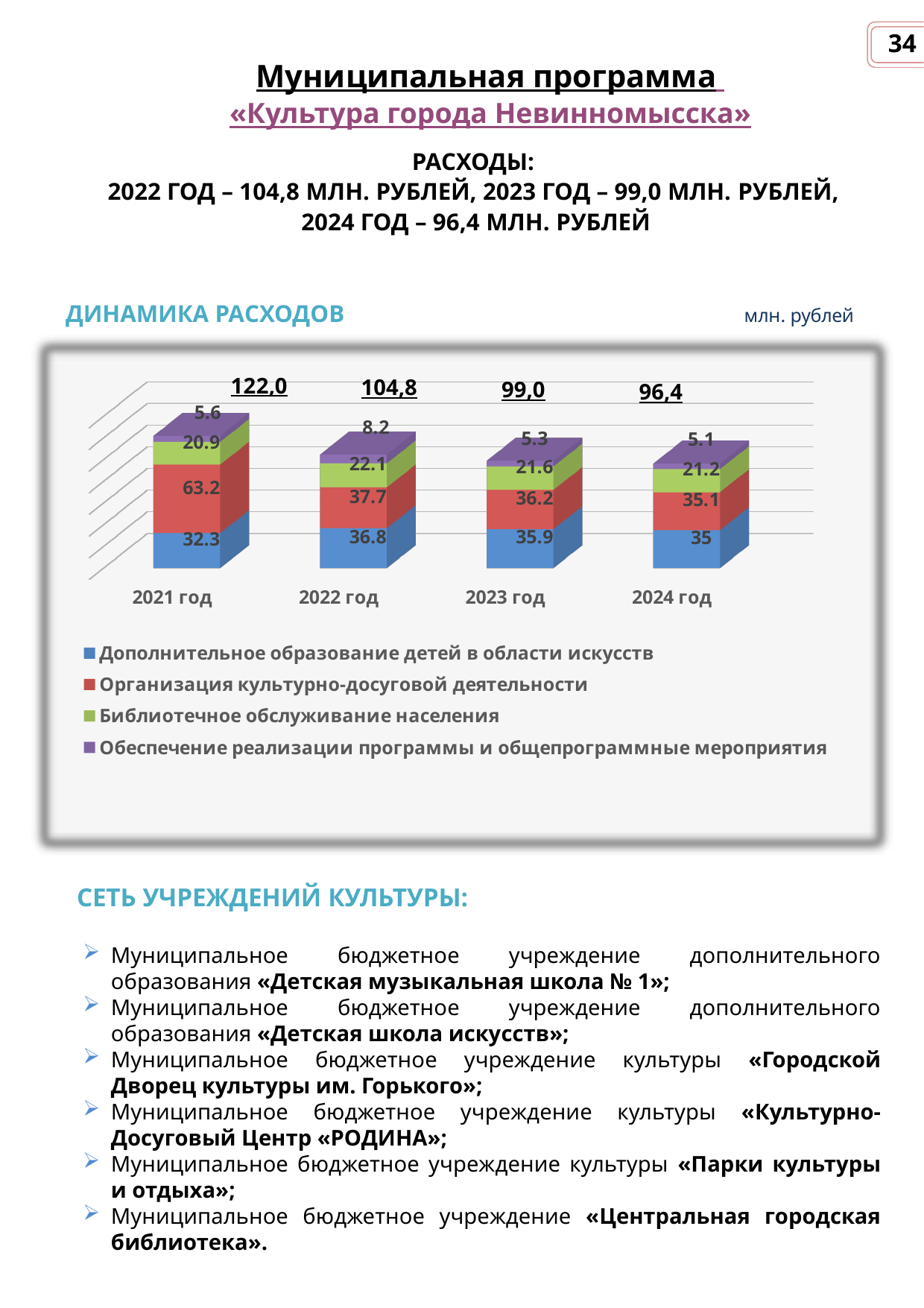
Which year has the lowest total expenditure in the chart? 2024 год What is the value for «Библиотечное обслуживание населения» in 2023 год? 21.6 Do the total expenditures rise or fall from 2021 год to 2024 год? Fall What is the value for «Дополнительное образование детей в области искусств» in 2022 год? 36.8 What is the value for «Обеспечение реализации программы и общепрограммные мероприятия» in 2024 год? 5.1 How many years (categories) are shown on the x axis of the chart? 4 How many series does the legend of the chart list? 4 What type of chart is shown under «ДИНАМИКА РАСХОДОВ»? Stacked bar chart Which year has the highest total expenditure in the chart? 2021 год What is the difference between the «Организация культурно-досуговой деятельности» values for 2021 год and 2022 год? 25.5 What is the total of the stacked bar for 2022 год? 104,8 What is the value for «Организация культурно-досуговой деятельности» in 2021 год? 63.2